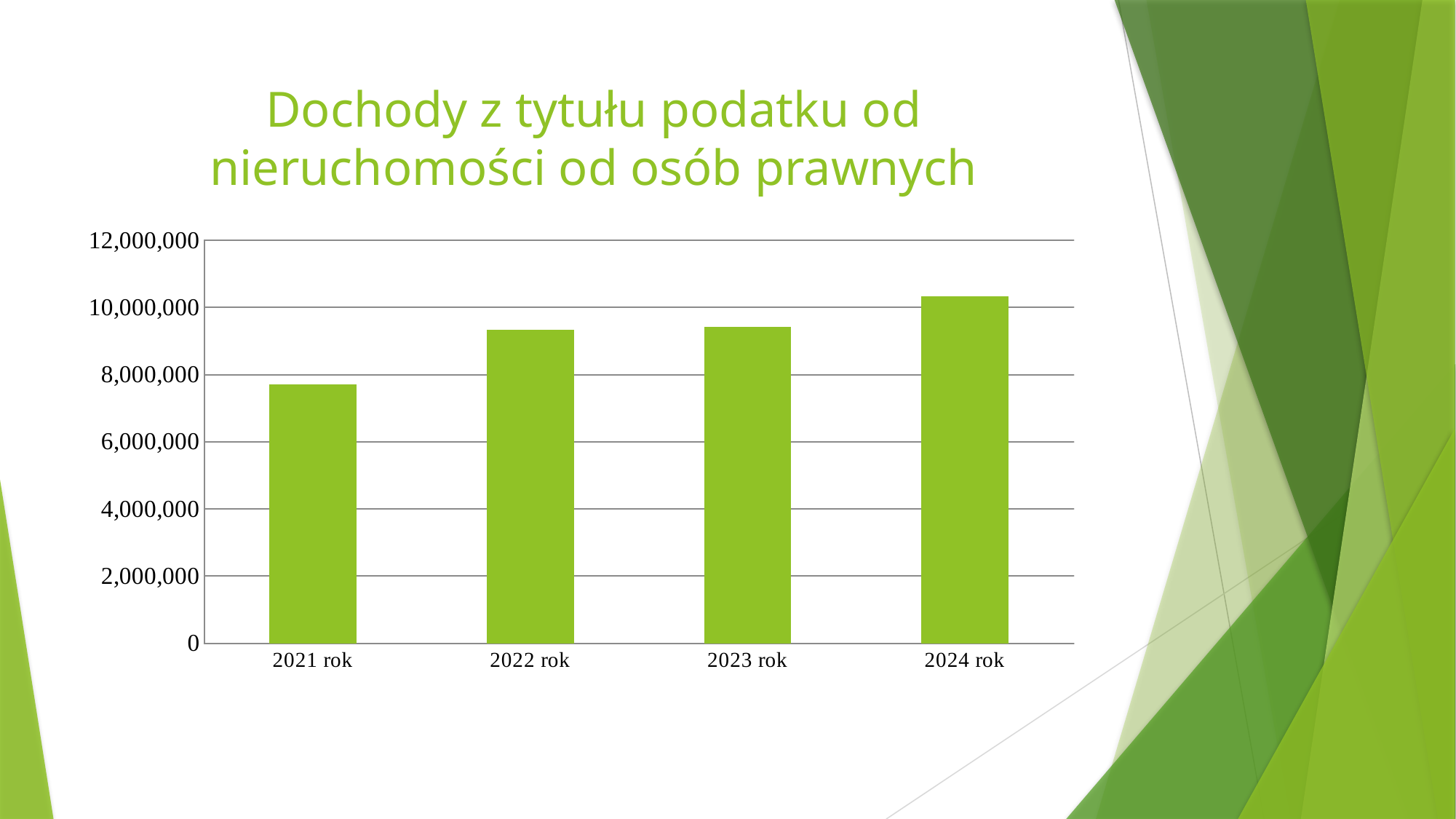
Which is larger, the value for 2021 rok or the value for 2022 rok? 2022 rok Which year has the highest value in the chart? 2024 rok What is the title of the chart on the slide? Dochody z tytułu podatku od nieruchomości od osób prawnych Do the values generally rise or fall from 2021 rok to 2024 rok? rise Which is larger, the value for 2021 rok or the value for 2024 rok? 2024 rok Is the value for 2021 rok greater or less than 8,000,000? less Is the value for 2024 rok greater or less than 10,000,000? greater Is the value for 2022 rok greater or less than 8,000,000? greater Which year has the lowest value in the chart? 2021 rok How many years (categories) are shown on the x axis of the chart? 4 What kind of chart is shown on the slide? bar chart